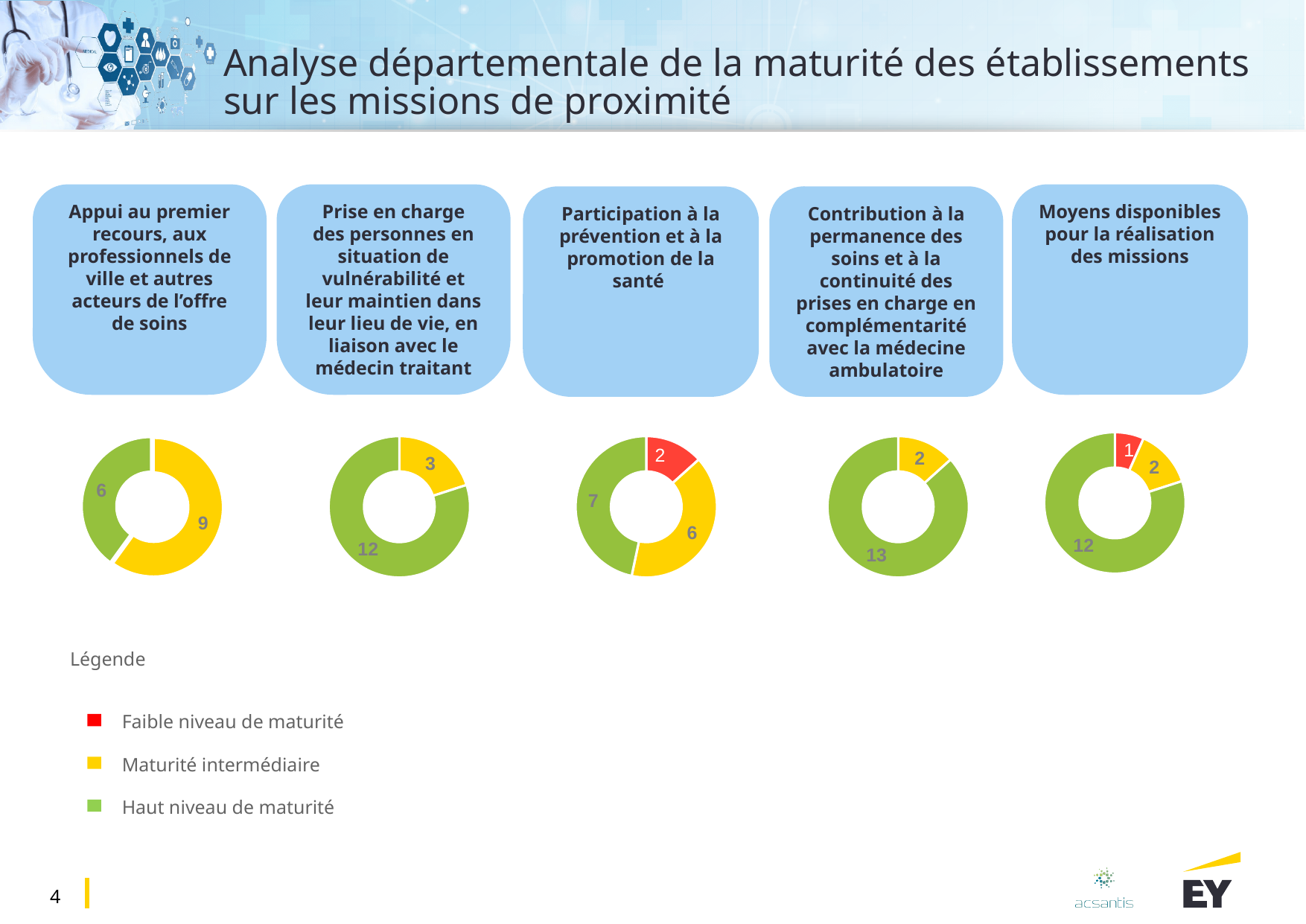
According to the legend, which maturity level is shown in red? Faible niveau de maturité In the donut chart under "Contribution à la permanence des soins...", which maturity level has the largest value? Haut niveau de maturité In the donut chart under "Participation à la prévention et à la promotion de la santé", which is larger: "Haut niveau de maturité" or "Maturité intermédiaire"? Haut niveau de maturité In the donut chart under "Prise en charge des personnes en situation de vulnérabilité...", what share of the total does the "Haut niveau de maturité" slice (12 out of 15) represent? 80% In the donut chart under "Appui au premier recours, aux professionnels de ville et autres acteurs de l'offre de soins", what is the value for "Maturité intermédiaire" (yellow)? 9 What type of chart is used under each of the five mission boxes? Donut chart In the donut chart under "Prise en charge des personnes en situation de vulnérabilité...", what is the value for "Haut niveau de maturité" (green)? 12 In the donut chart under "Appui au premier recours...", what share of the total does the "Maturité intermédiaire" slice (9 out of 15) represent? 60% In the donut chart under "Moyens disponibles pour la réalisation des missions", which maturity level has the smallest value? Faible niveau de maturité How many slices does the donut chart under "Moyens disponibles pour la réalisation des missions" have? 3 In the donut chart under "Appui au premier recours...", what is the difference between the "Maturité intermédiaire" value and the "Haut niveau de maturité" value? 3 In the donut chart under "Participation à la prévention et à la promotion de la santé", what is the value for "Faible niveau de maturité" (red)? 2